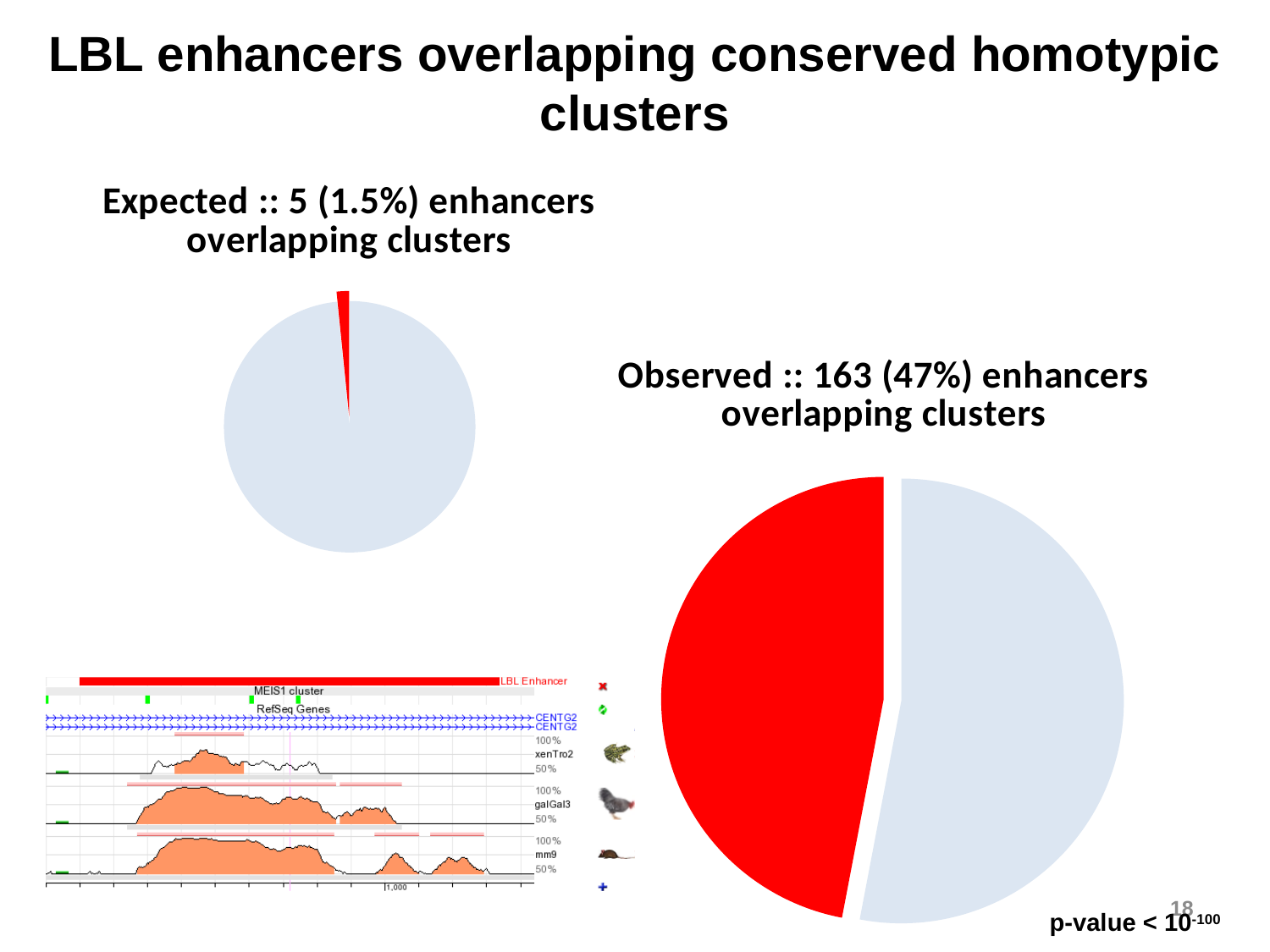
In the 'Observed' pie chart, what share of the pie does the red slice (enhancers overlapping clusters) represent? 47% Which pie chart has the larger red slice, 'Expected' or 'Observed'? Observed In the 'Expected' pie chart, how many enhancers are expected to overlap clusters? 5 What kind of chart is the 'Expected' chart on the left of the slide? pie chart How many slices does the 'Observed' pie chart have? 2 How many pie charts are shown on the slide? 2 In the 'Observed' pie chart, how many enhancers were observed overlapping clusters? 163 In the 'Observed' pie chart, is the red slice greater or less than 50% of the pie? less What colour is the slice representing enhancers overlapping clusters in both pie charts? red What is the difference in percentage points between the observed share (47%) and the expected share (1.5%) of enhancers overlapping clusters? 45.5% In the 'Expected' pie chart, what share of the pie does the red slice (enhancers overlapping clusters) represent? 1.5% What is the difference between the observed (163) and expected (5) numbers of enhancers overlapping clusters? 158